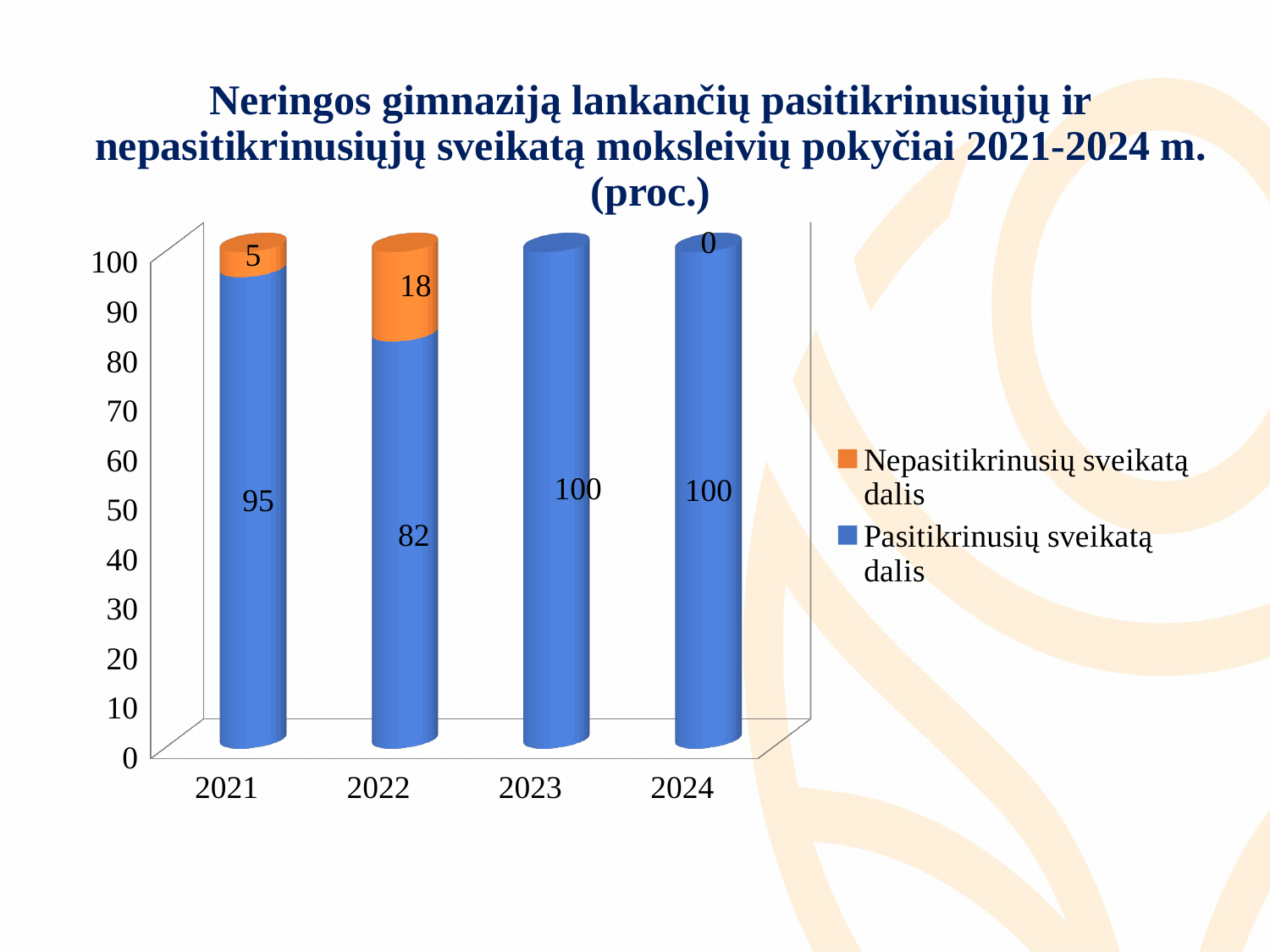
What is the difference between Pasitikrinusių sveikatą dalis in 2021 and 2022? 13 What is the value of Nepasitikrinusių sveikatą dalis for 2021? 5 How many years are shown on the x axis? 4 Which is larger: Pasitikrinusių sveikatą dalis in 2021 or in 2022? 2021 What is the value of Nepasitikrinusių sveikatą dalis for 2024? 0 What is the value of Nepasitikrinusių sveikatą dalis for 2022? 18 In which year is Nepasitikrinusių sveikatą dalis the highest? 2022 What is the value of Pasitikrinusių sveikatą dalis for 2022? 82 How many series does the legend list? 2 What is the value of Pasitikrinusių sveikatą dalis for 2023? 100 What is the total of the stacked bar for 2022? 100 In which year is Pasitikrinusių sveikatą dalis the lowest? 2022